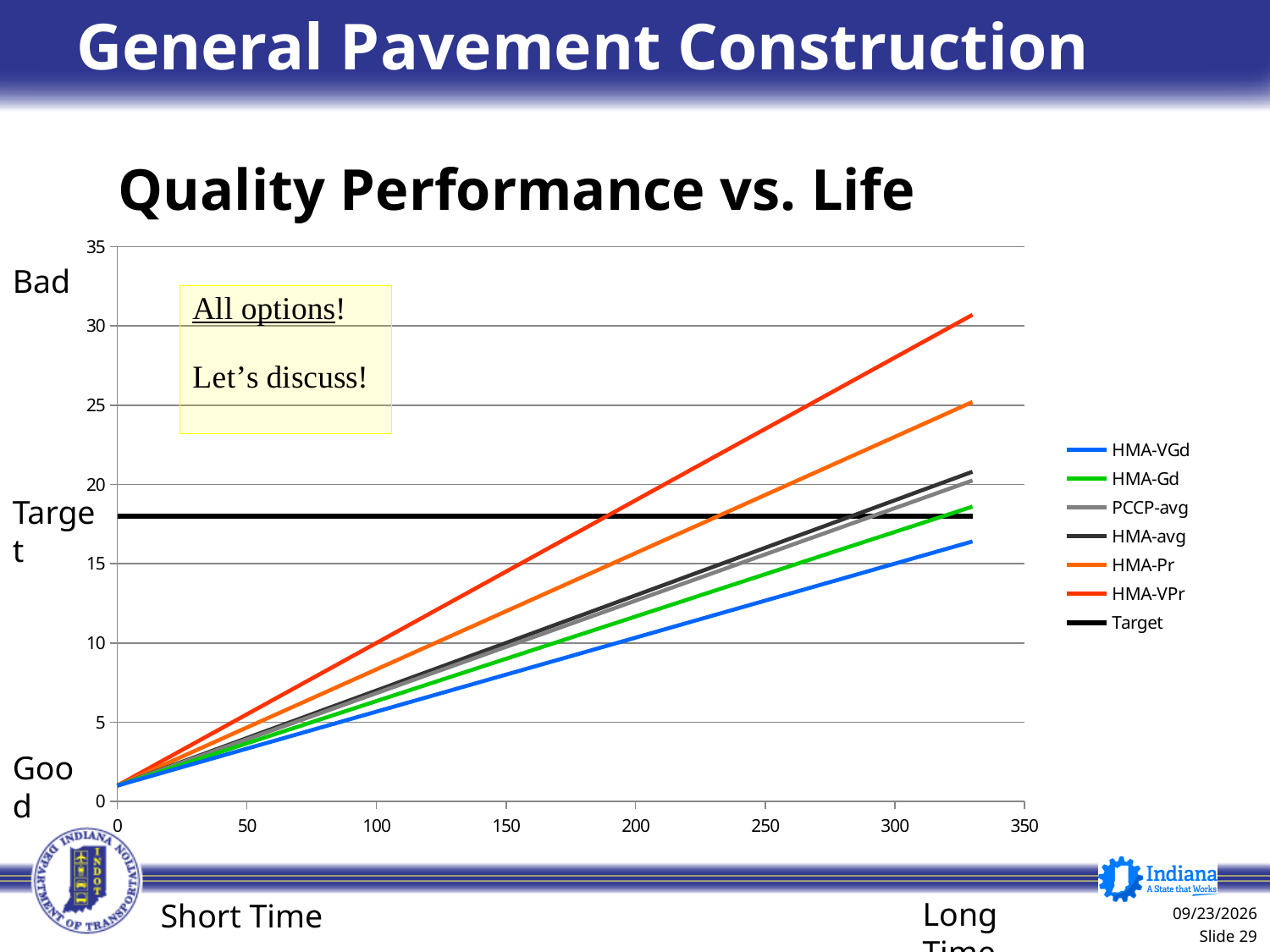
Do the HMA-VPr values rise or fall as the x axis increases? rise What is the title of the chart? Quality Performance vs. Life Which series has the lowest value at the right end of the chart (x = 330)? HMA-VGd How many series does the chart legend list? 7 At x = 250, is the value for HMA-VGd greater or less than 15? less At x = 300, which is larger: the value for HMA-VPr or the value for HMA-Gd? HMA-VPr Which series is the first to cross the Target line as x increases? HMA-VPr Is the Target line greater or less than 20 on the y axis? less What kind of chart is shown on the slide? line chart Which legend entry is drawn as a black horizontal line? Target At x = 300, is the value for HMA-VPr greater or less than 25? greater Which series has the highest value at the right end of the chart (x = 330)? HMA-VPr